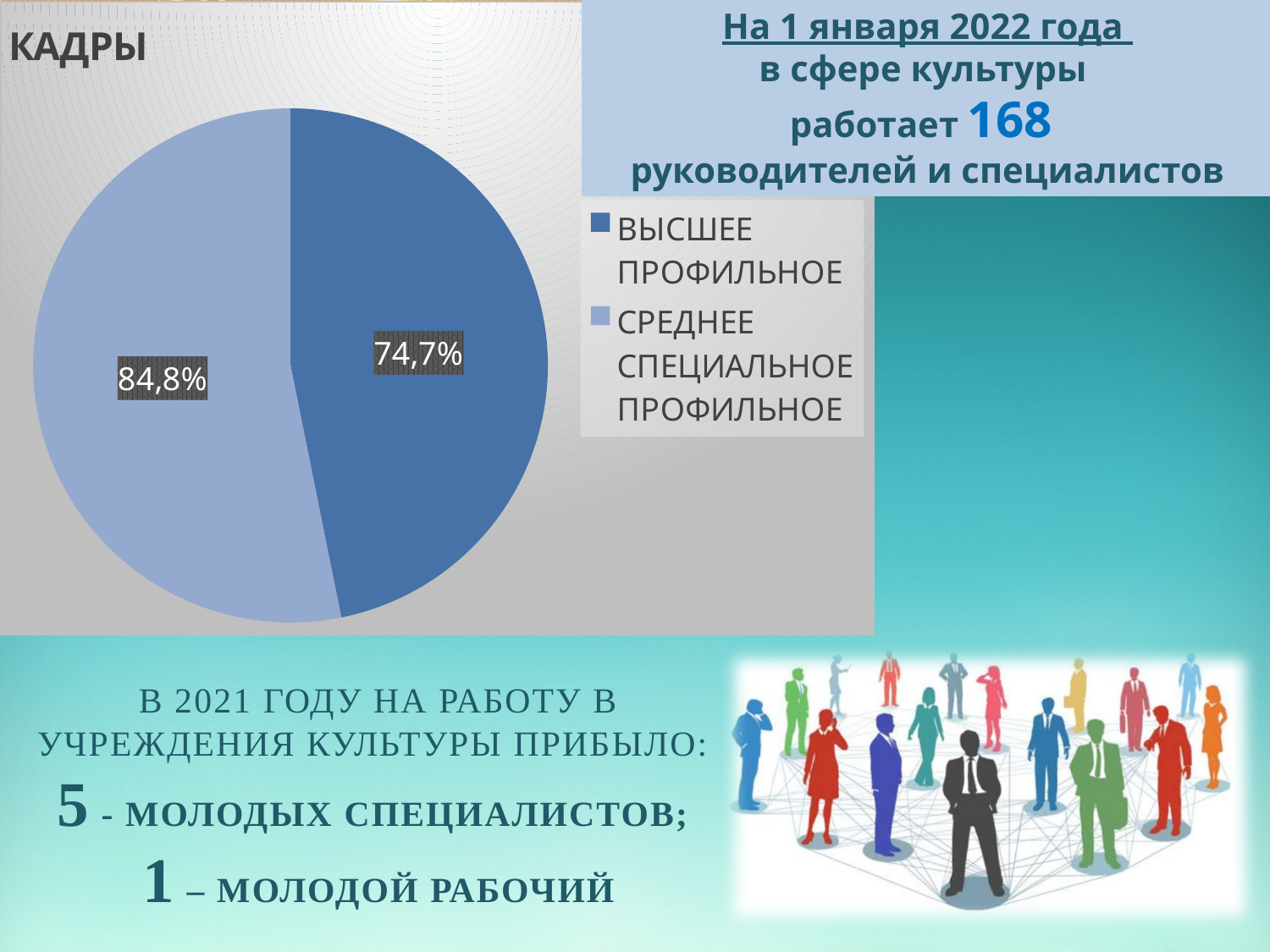
What kind of chart is shown on the slide? pie chart How many slices does the pie chart have? 2 Which legend entry is shown in the darker blue colour? ВЫСШЕЕ ПРОФИЛЬНОЕ What value is shown for the СРЕДНЕЕ СПЕЦИАЛЬНОЕ ПРОФИЛЬНОЕ slice of the pie chart? 84,8% Which slice of the pie chart has the higher printed value? СРЕДНЕЕ СПЕЦИАЛЬНОЕ ПРОФИЛЬНОЕ Which printed value is larger: ВЫСШЕЕ ПРОФИЛЬНОЕ or СРЕДНЕЕ СПЕЦИАЛЬНОЕ ПРОФИЛЬНОЕ? СРЕДНЕЕ СПЕЦИАЛЬНОЕ ПРОФИЛЬНОЕ What value is shown for the ВЫСШЕЕ ПРОФИЛЬНОЕ slice of the pie chart? 74,7% What is the difference between the printed values for СРЕДНЕЕ СПЕЦИАЛЬНОЕ ПРОФИЛЬНОЕ and ВЫСШЕЕ ПРОФИЛЬНОЕ? 10,1% Which slice of the pie chart has the lower printed value? ВЫСШЕЕ ПРОФИЛЬНОЕ What is the title shown above the pie chart? КАДРЫ How many entries does the legend of the pie chart list? 2